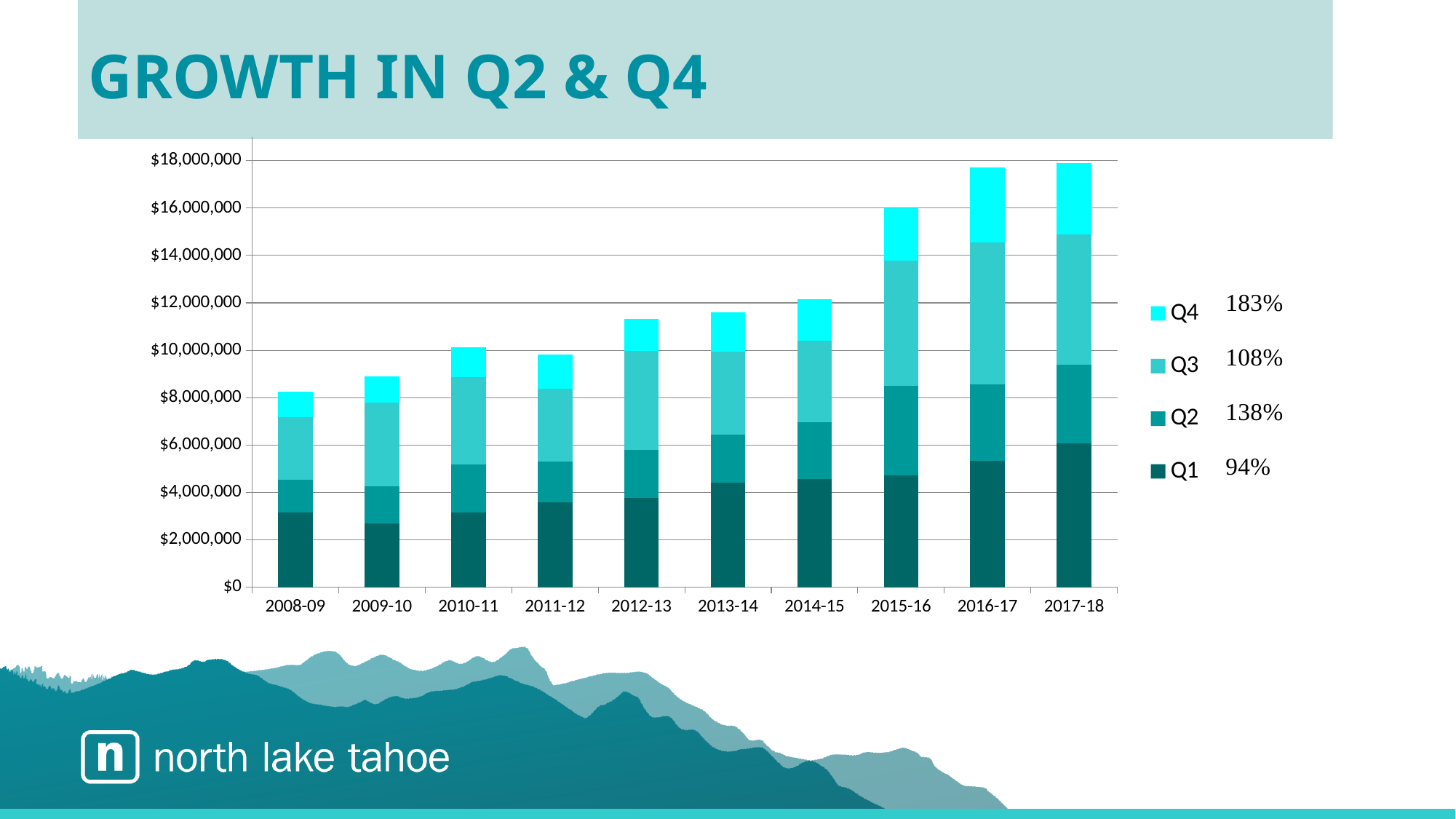
Do the total bars generally rise or fall from 2008-09 to 2017-18? rise Is the total bar for 2008-09 greater or less than $10,000,000? less Is the total bar for 2017-18 greater or less than $16,000,000? greater How many series does the chart's legend list? 4 Is the total bar for 2009-10 greater or less than $10,000,000? less What is the title of the slide containing the chart? GROWTH IN Q2 & Q4 Which fiscal year has the lowest total bar in the chart? 2008-09 What percentage is printed next to the Q4 legend entry? 183% How many fiscal years are shown on the x axis of the chart? 10 What kind of chart is shown on the slide? stacked bar chart Which fiscal year has the larger total bar, 2014-15 or 2015-16? 2015-16